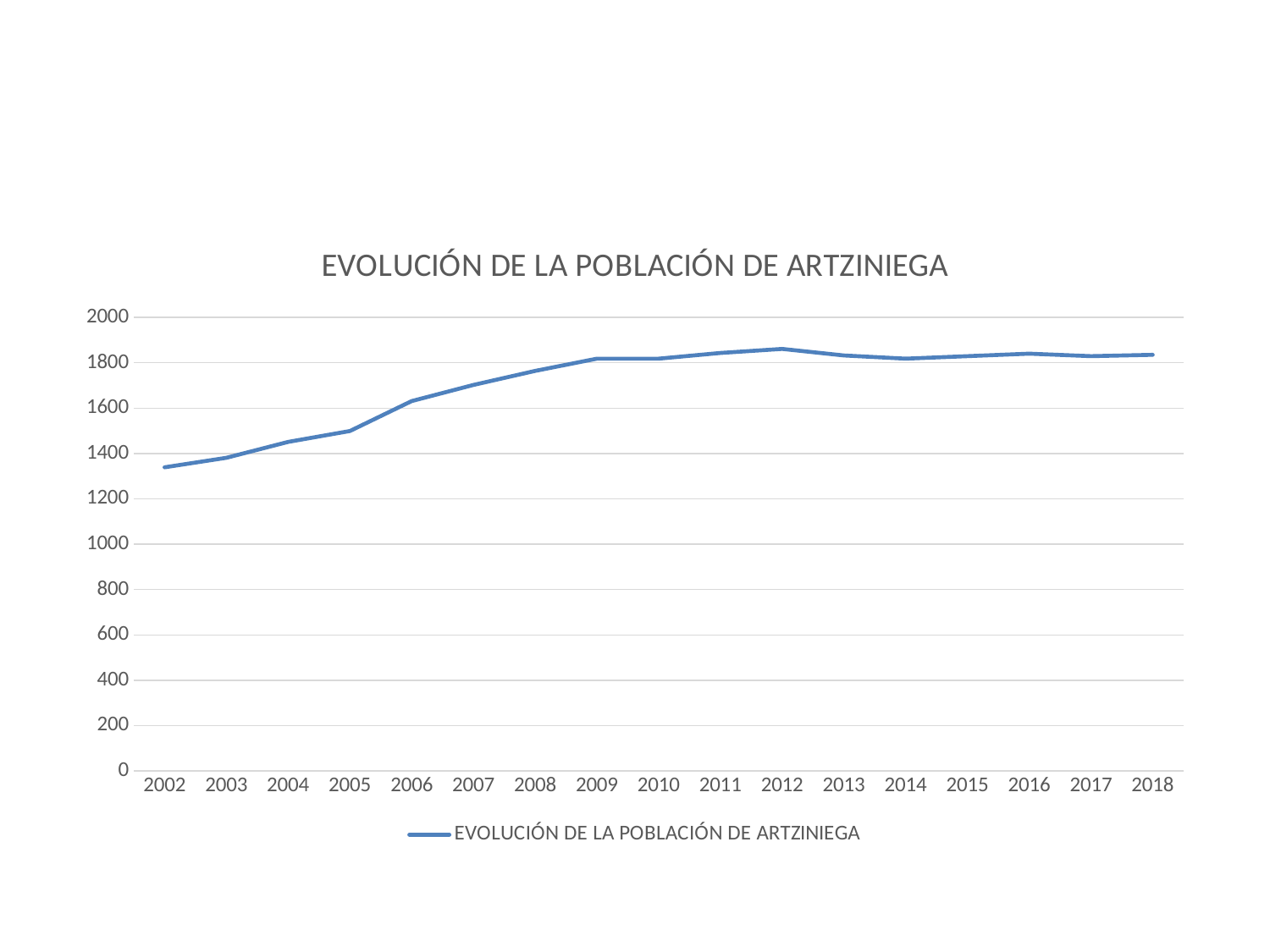
Which year has the lowest population value? 2002 Is the value for 2005 greater or less than 1600? less How many years are plotted along the x axis? 17 What is the title of the chart? EVOLUCIÓN DE LA POBLACIÓN DE ARTZINIEGA Is the value for 2006 greater or less than 1600? greater Is the value for 2018 greater or less than 1800? greater How many series does the legend list? 1 Does the population generally rise or fall from 2002 to 2009? rise Which is larger, the value for 2002 or the value for 2006? 2006 What kind of chart is shown on the slide? line chart